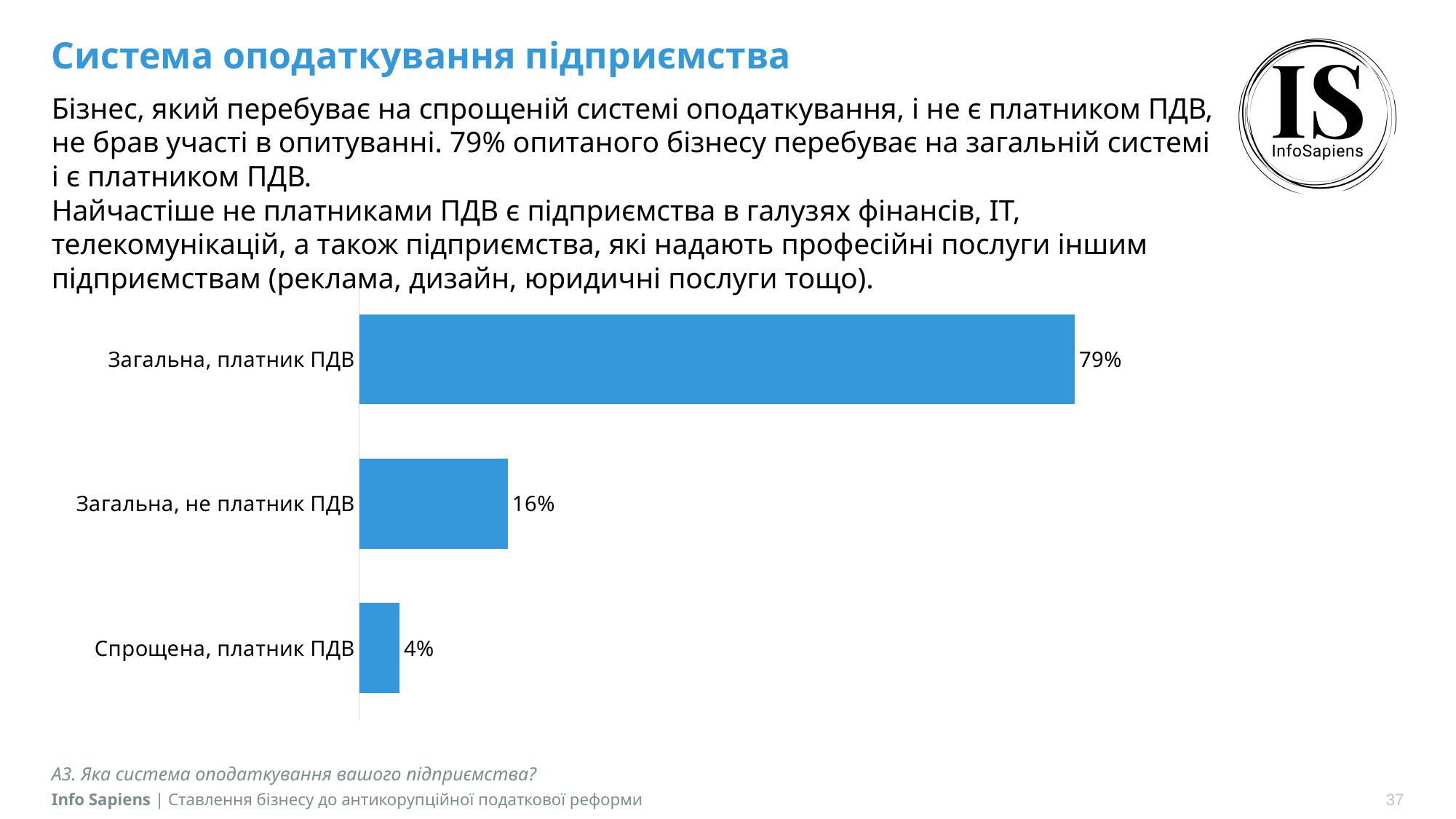
Which category has the lowest value? Спрощена, платник ПДВ What is the value for "Загальна, не платник ПДВ"? 16% Which category has the highest value? Загальна, платник ПДВ What kind of chart is shown on the slide? Bar chart What is the difference between the values for "Загальна, не платник ПДВ" and "Спрощена, платник ПДВ"? 12% Which is larger: the value for "Загальна, не платник ПДВ" or "Спрощена, платник ПДВ"? Загальна, не платник ПДВ What is the value for "Загальна, платник ПДВ"? 79% What is the value for "Спрощена, платник ПДВ"? 4% What is the title of the slide containing the chart? Система оподаткування підприємства What is the total of the three values shown in the chart? 99% How many categories are shown in the chart? 3 What is the difference between the values for "Загальна, платник ПДВ" and "Загальна, не платник ПДВ"? 63%